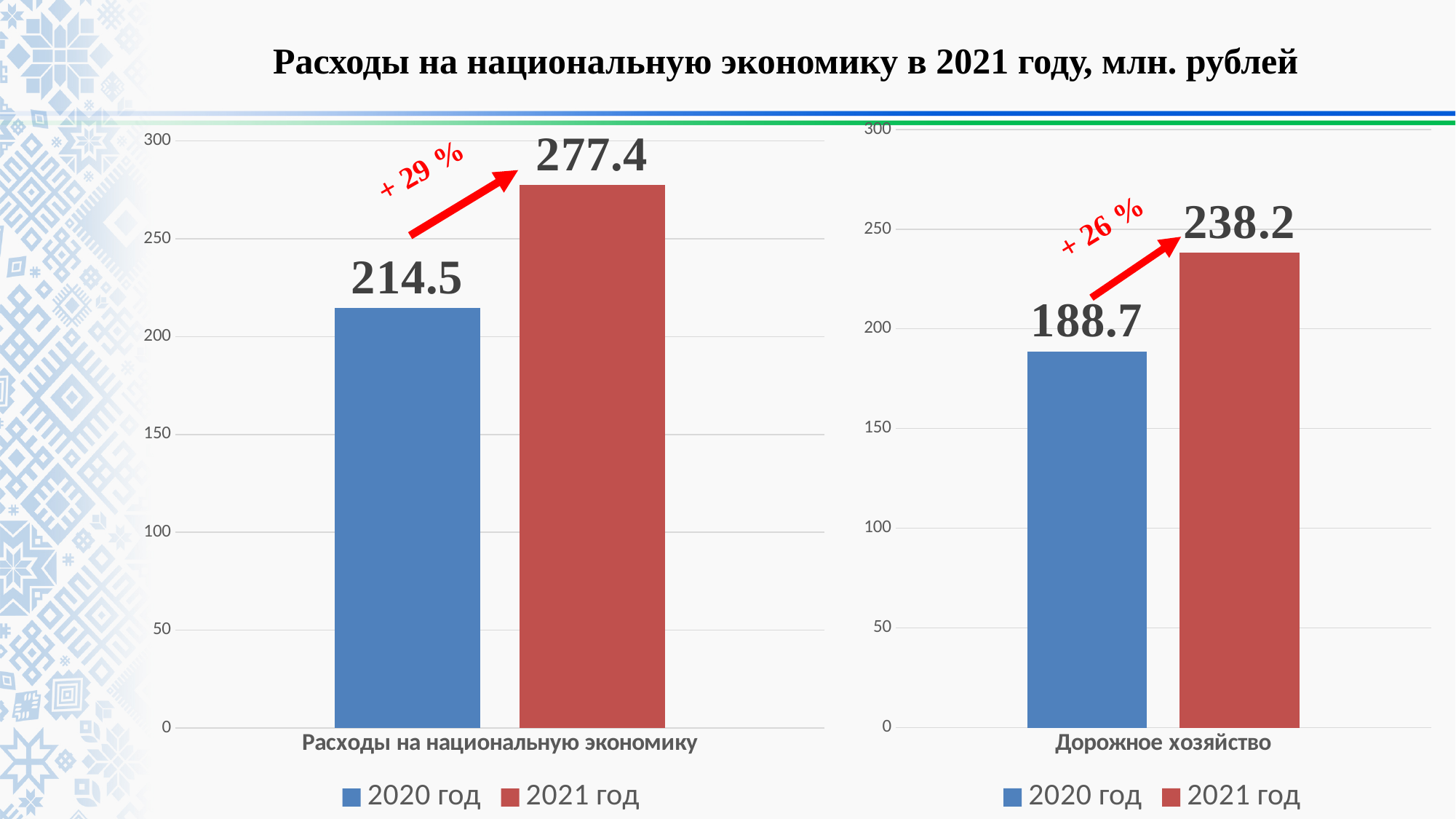
In the left chart (Расходы на национальную экономику), what is the value for 2020 год? 214.5 In the right chart (Дорожное хозяйство), what is the value for 2021 год? 238.2 In the right chart (Дорожное хозяйство), what is the difference between the 2021 год and 2020 год values? 49.5 In the left chart (Расходы на национальную экономику), what is the difference between the 2021 год and 2020 год values? 62.9 In the right chart (Дорожное хозяйство), which series has the larger value, 2020 год or 2021 год? 2021 год In the right chart (Дорожное хозяйство), what is the value for 2020 год? 188.7 How many series does the legend of the left chart (Расходы на национальную экономику) list? 2 In the left chart (Расходы на национальную экономику), is the value for 2020 год greater or less than 200? greater What percentage increase is annotated on the right chart (Дорожное хозяйство)? + 26 % In the left chart (Расходы на национальную экономику), what is the value for 2021 год? 277.4 What kind of chart is the right chart (Дорожное хозяйство)? bar chart In the right chart (Дорожное хозяйство), is the value for 2020 год greater or less than 200? less